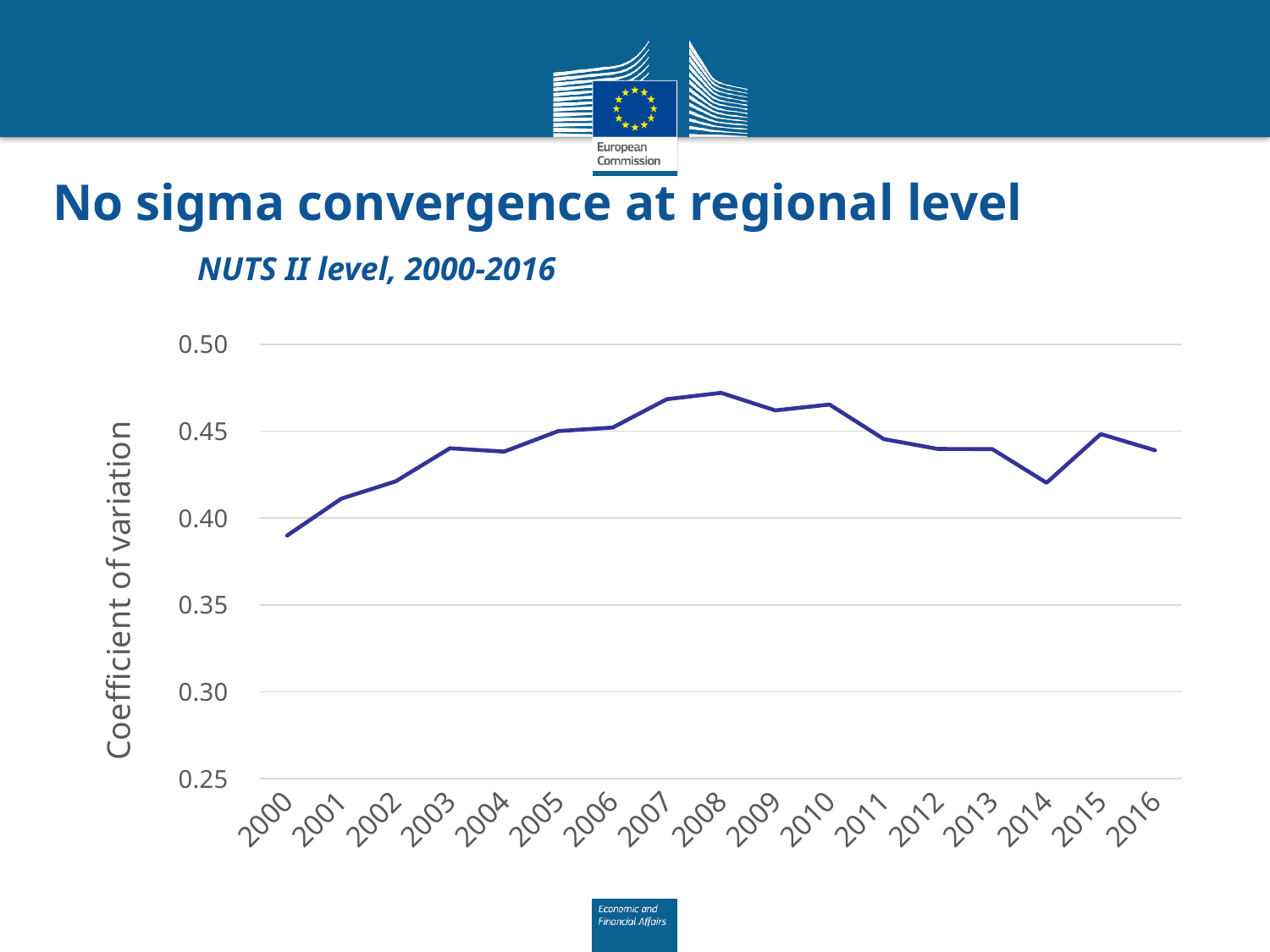
What kind of chart is shown on the slide? line chart How many years are plotted along the x axis? 17 Is the value for 2001 greater or less than 0.40? greater In which year is the coefficient of variation lowest? 2000 In which year is the coefficient of variation highest? 2008 Which year has the higher coefficient of variation, 2014 or 2015? 2015 Does the coefficient of variation rise or fall between 2000 and 2008? rise Which year has the higher coefficient of variation, 2000 or 2008? 2008 Is the value for 2014 greater or less than 0.45? less What is the label on the vertical axis of the chart? Coefficient of variation Is the value for 2008 greater or less than 0.45? greater